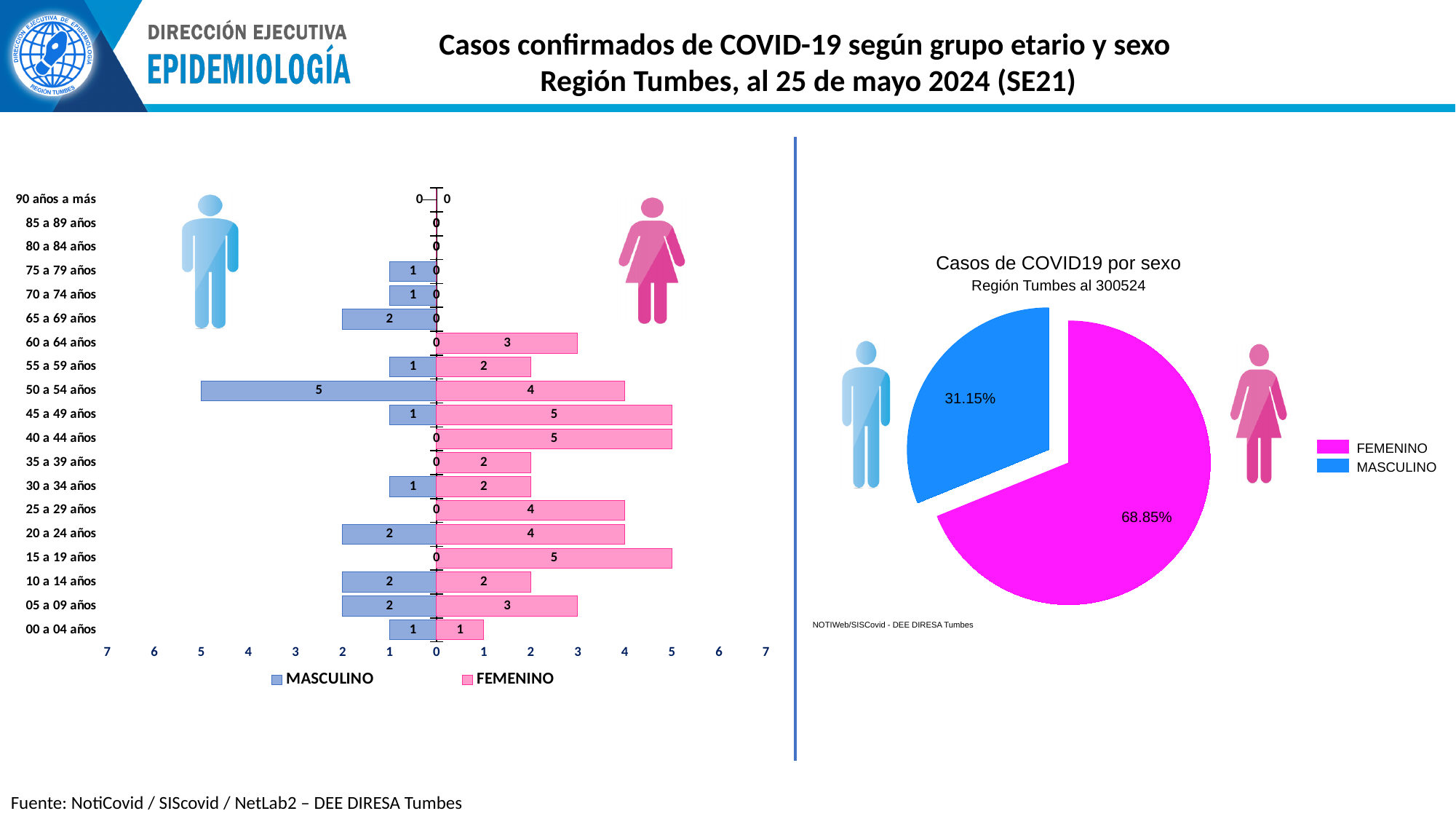
In the pie chart 'Casos de COVID19 por sexo', what share is MASCULINO? 31.15% In the pie chart 'Casos de COVID19 por sexo', what share is FEMENINO? 68.85% In the left chart (age and sex pyramid), which age group has the highest MASCULINO value? 50 a 54 años In the left chart (age and sex pyramid), how many series does the legend list? 2 In the left chart (age and sex pyramid), which is larger for 20 a 24 años: MASCULINO or FEMENINO? FEMENINO In the left chart (age and sex pyramid), how many MASCULINO cases are in the 50 a 54 años group? 5 In the left chart (age and sex pyramid), how many age groups are shown? 19 In the pie chart 'Casos de COVID19 por sexo', which slice is larger: FEMENINO or MASCULINO? FEMENINO What kind of chart is the left chart showing cases by age group and sex? Bar chart In the left chart (age and sex pyramid), how many FEMENINO cases are in the 60 a 64 años group? 3 In the left chart (age and sex pyramid), what is the difference between the FEMENINO and MASCULINO values for 45 a 49 años? 4 In the pie chart 'Casos de COVID19 por sexo', what colour is the MASCULINO slice? Blue